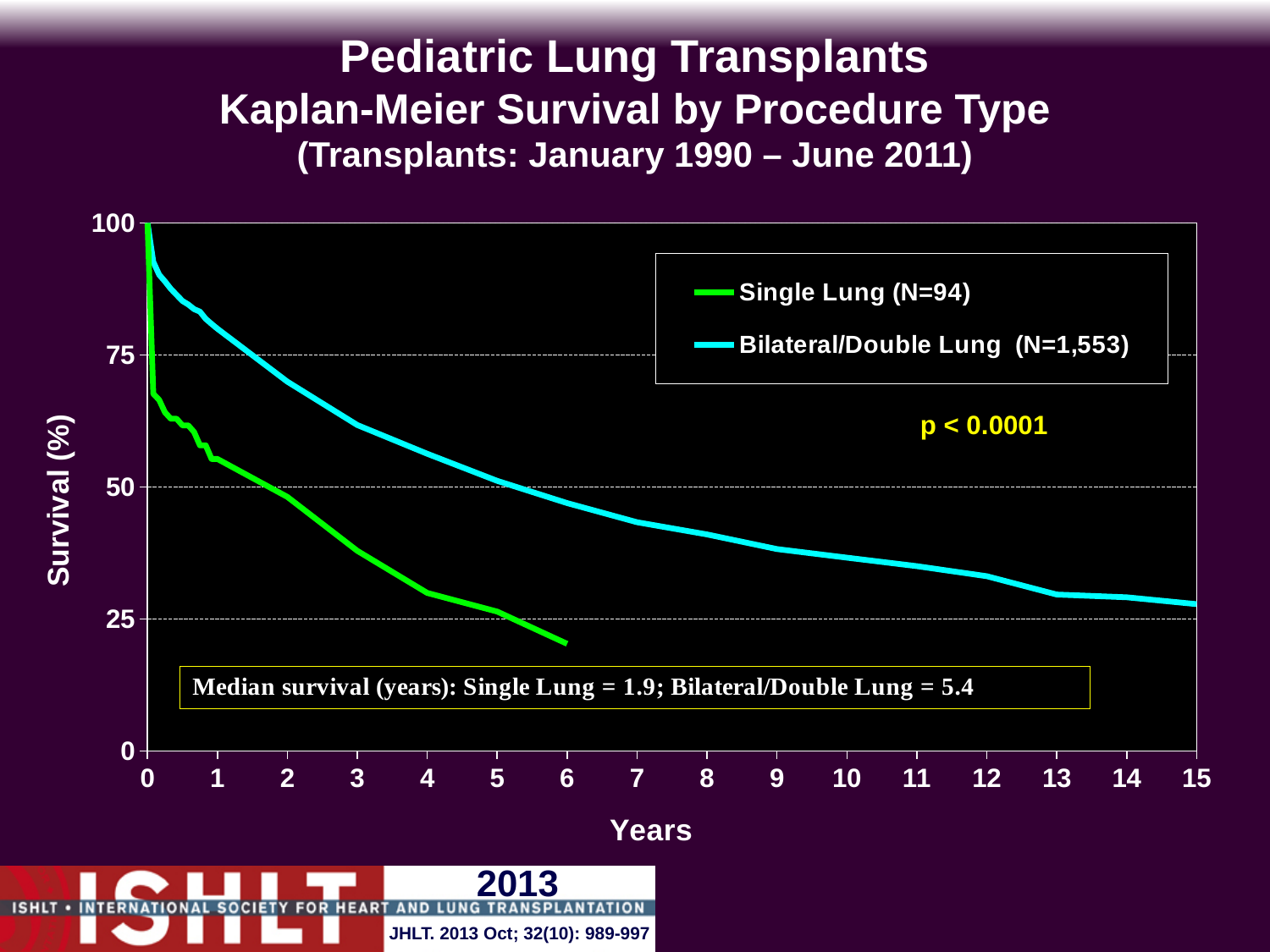
Is the survival for Bilateral/Double Lung at 3 years greater or less than 50? greater Do the survival curves rise or fall as years increase? fall What is the median survival in years for Single Lung transplants? 1.9 Which procedure type has the higher survival at 5 years, Single Lung or Bilateral/Double Lung? Bilateral/Double Lung According to the legend, how many patients are in the Bilateral/Double Lung group? N=1,553 What kind of chart is shown on the slide? line chart Is the survival for Single Lung at 3 years greater or less than 50? less What is the median survival in years for Bilateral/Double Lung transplants? 5.4 Is the survival for Bilateral/Double Lung at 15 years greater or less than 25? greater What p-value is shown on the chart? p < 0.0001 How many series does the legend list? 2 By how many years does the median survival for Bilateral/Double Lung exceed that for Single Lung? 3.5